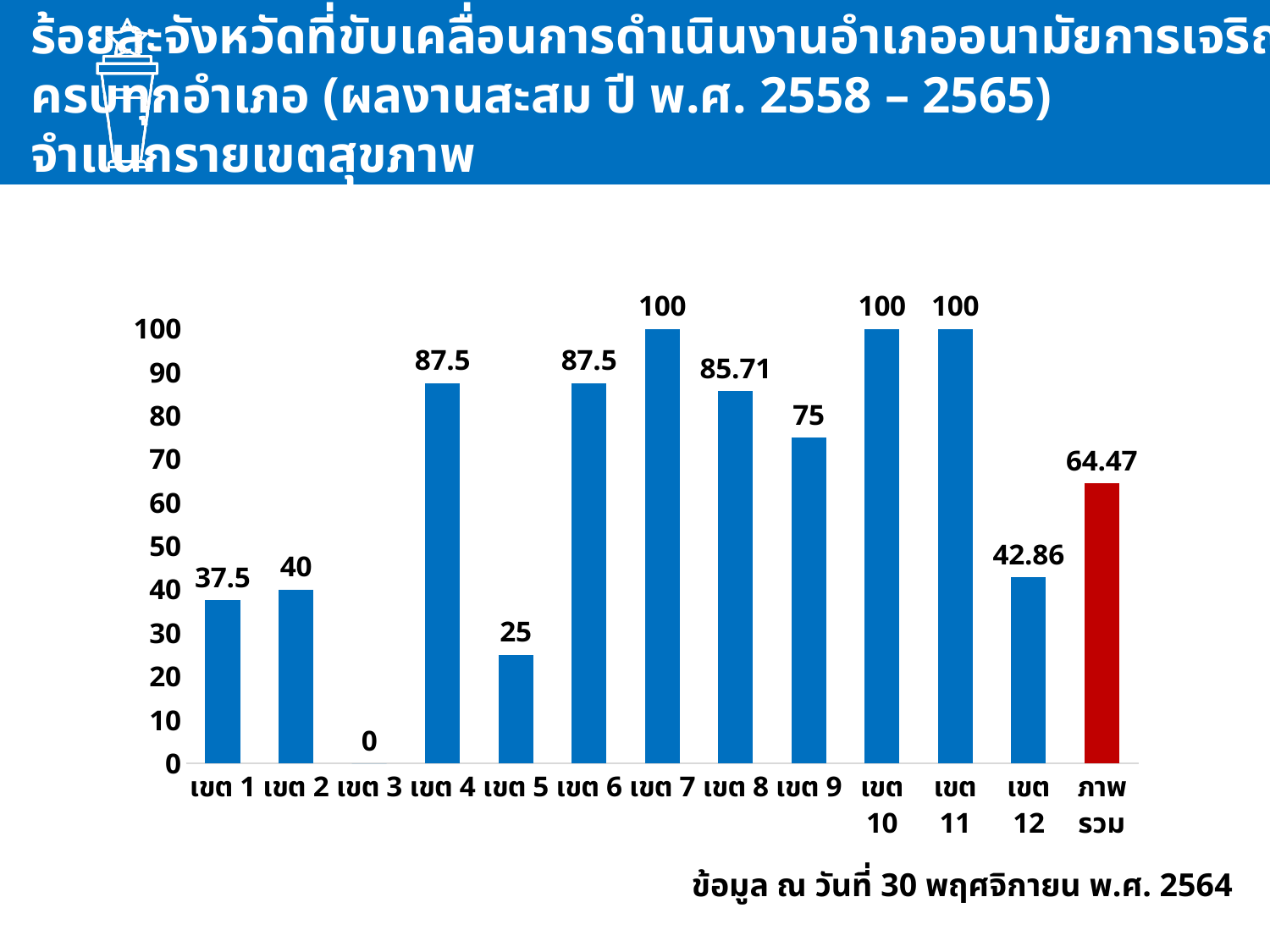
Which category has the lowest value? เขต 3 How many categories are shown on the x axis? 13 What is the value for เขต 8? 85.71 What is the value for เขต 4? 87.5 What is the difference between the values for เขต 2 and เขต 1? 2.5 What is the value for เขต 12? 42.86 What is the difference between the values for เขต 9 and เขต 5? 50 What kind of chart is shown on the slide? bar chart What is the value for ภาพรวม? 64.47 How many categories have a value of 100? 3 Which bar is coloured red rather than blue? ภาพรวม Which is larger, the value for เขต 12 or the value for เขต 2? เขต 12